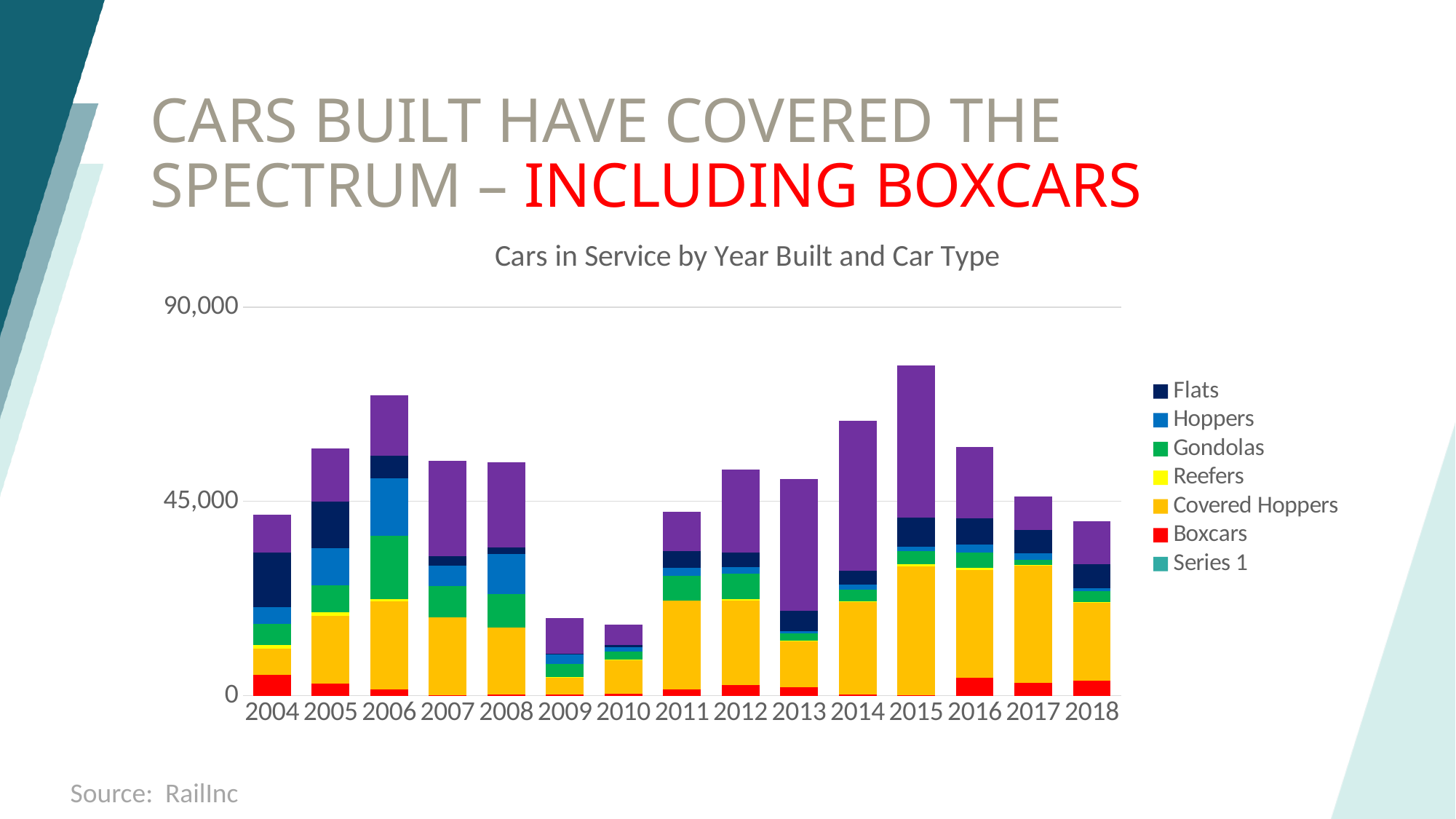
What kind of chart is shown on the slide? Stacked bar chart Which year has the taller total bar, 2014 or 2016? 2014 Is the total bar for 2006 greater or less than 45,000? greater What is the title of the chart? Cars in Service by Year Built and Car Type Is the total bar for 2015 greater or less than 45,000? greater How many series does the chart's legend list? 7 Is the total bar for 2009 greater or less than 45,000? less How many years are shown along the x axis of the chart? 15 Which year has the largest Gondolas segment? 2006 Which year has the tallest total bar in the chart? 2015 Do the total bar heights rise or fall from 2015 to 2018? fall Which year has the shortest total bar in the chart? 2010